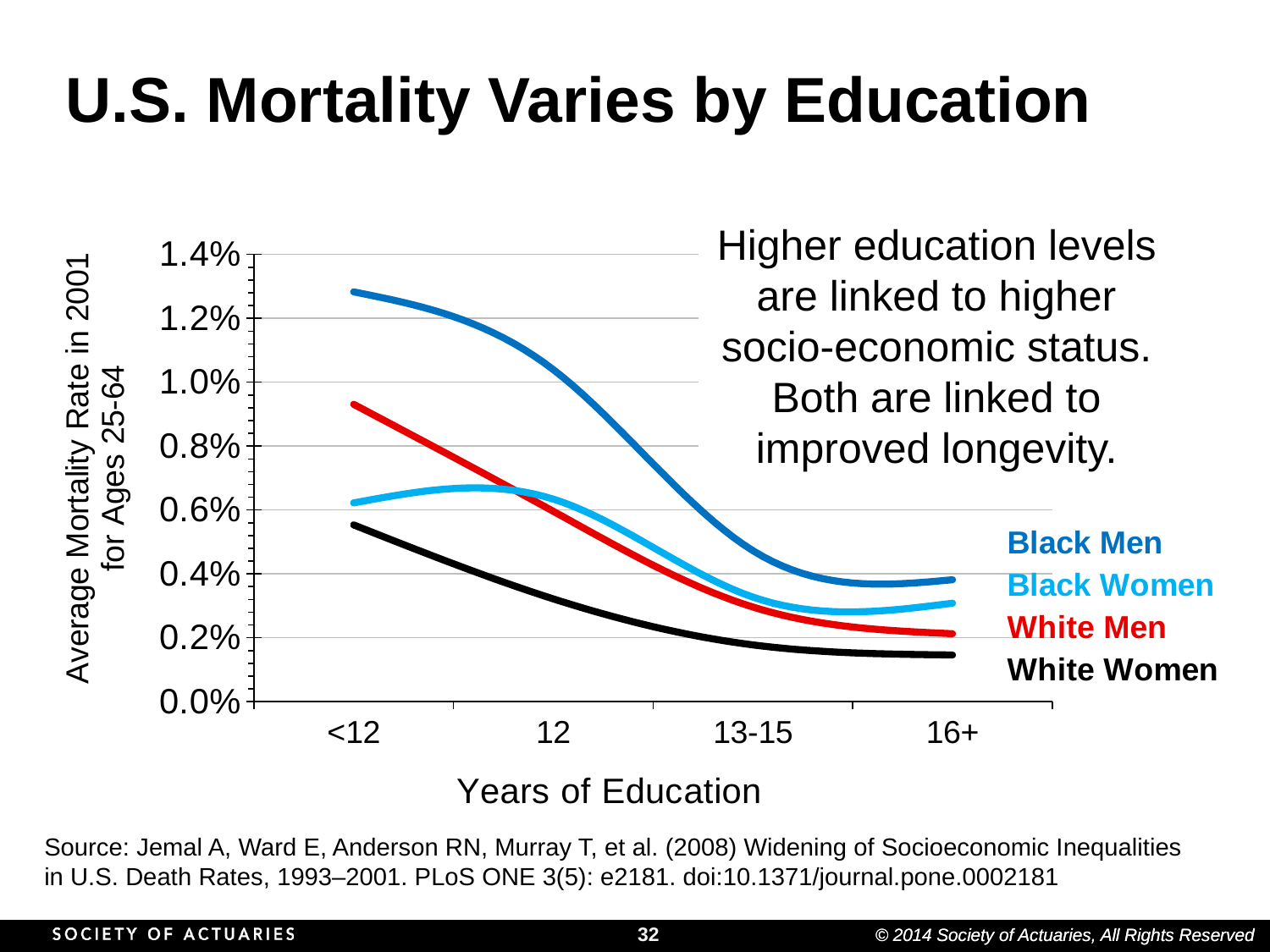
What kind of chart is shown on the slide? line chart Is the mortality rate for Black Men at <12 years of education greater or less than 1.2%? greater What colour is the line for White Men? red How many education categories are shown on the x axis? 4 How many series are plotted on the chart? 4 What is the title of the x axis? Years of Education Is the mortality rate for White Men at <12 years of education greater or less than 0.8%? greater Which group has the lowest mortality rate at 16+ years of education? White Women Is the mortality rate for White Women at 16+ years of education greater or less than 0.2%? less Which group has the highest mortality rate at <12 years of education? Black Men Does the mortality rate for Black Men rise or fall as years of education increase? fall At <12 years of education, which group has the higher mortality rate, Black Men or White Men? Black Men